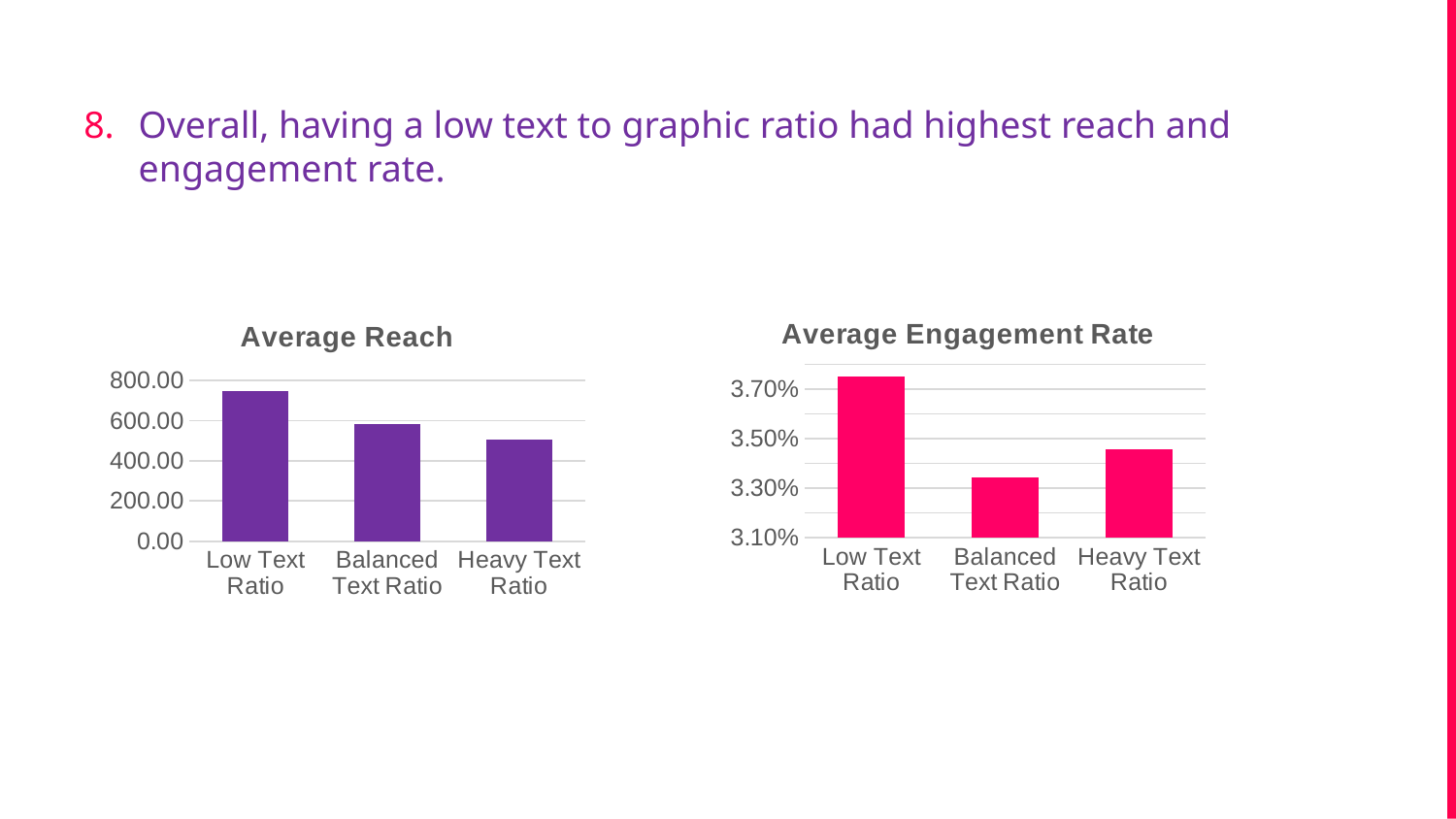
In the Average Engagement Rate chart, which category has the highest value? Low Text Ratio What kind of chart is the Average Engagement Rate chart? bar chart In the Average Engagement Rate chart, is the value for Balanced Text Ratio greater or less than 3.50%? less How many categories are shown in the Average Reach chart? 3 In the Average Reach chart, which category has the lowest value? Heavy Text Ratio In the Average Engagement Rate chart, which category has the lowest value? Balanced Text Ratio In the Average Engagement Rate chart, which is larger, the value for Heavy Text Ratio or Balanced Text Ratio? Heavy Text Ratio In the Average Reach chart, is the value for Low Text Ratio greater or less than 600.00? greater In the Average Reach chart, is the value for Heavy Text Ratio greater or less than 600.00? less In the Average Reach chart, which category has the highest value? Low Text Ratio